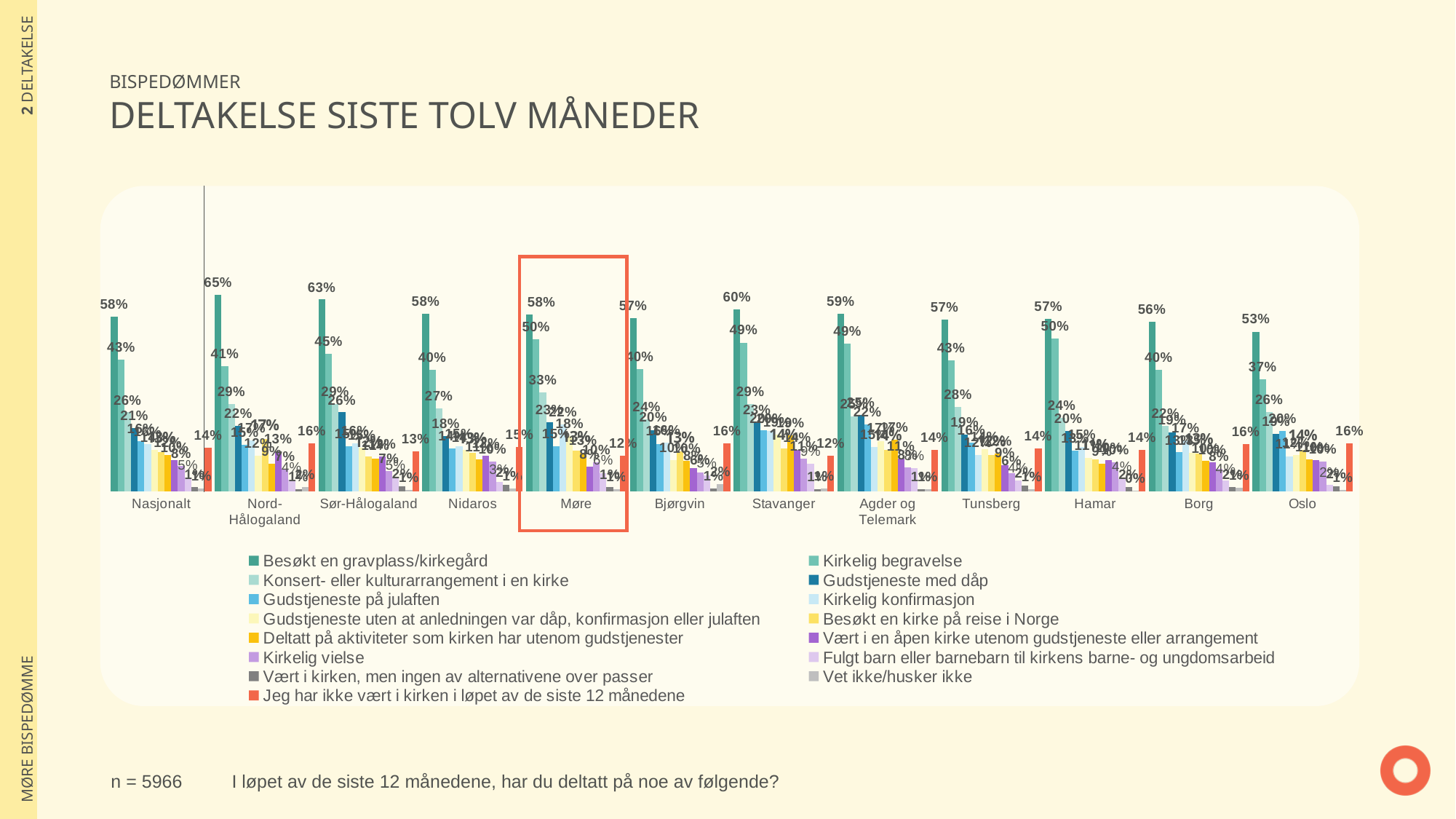
What is the difference between the 'Besøkt en gravplass/kirkegård' values for Nord-Hålogaland and Oslo? 12% How many series does the legend list? 15 What is the value for 'Konsert- eller kulturarrangement i en kirke' in Møre? 33% What is the value for 'Besøkt en gravplass/kirkegård' in Nord-Hålogaland? 65% Which is larger: 'Kirkelig begravelse' in Møre or in Nidaros? Møre What is the value for 'Kirkelig begravelse' in Møre? 50% What kind of chart is shown on the slide? bar chart Which category has the highest value for 'Besøkt en gravplass/kirkegård'? Nord-Hålogaland What is the value for 'Jeg har ikke vært i kirken i løpet av de siste 12 månedene' in Oslo? 16% How many categories (bispedømmer, including Nasjonalt) are shown along the x axis? 12 Which category has the lowest value for 'Besøkt en gravplass/kirkegård'? Oslo Which category is highlighted with a red rectangle on the chart? Møre